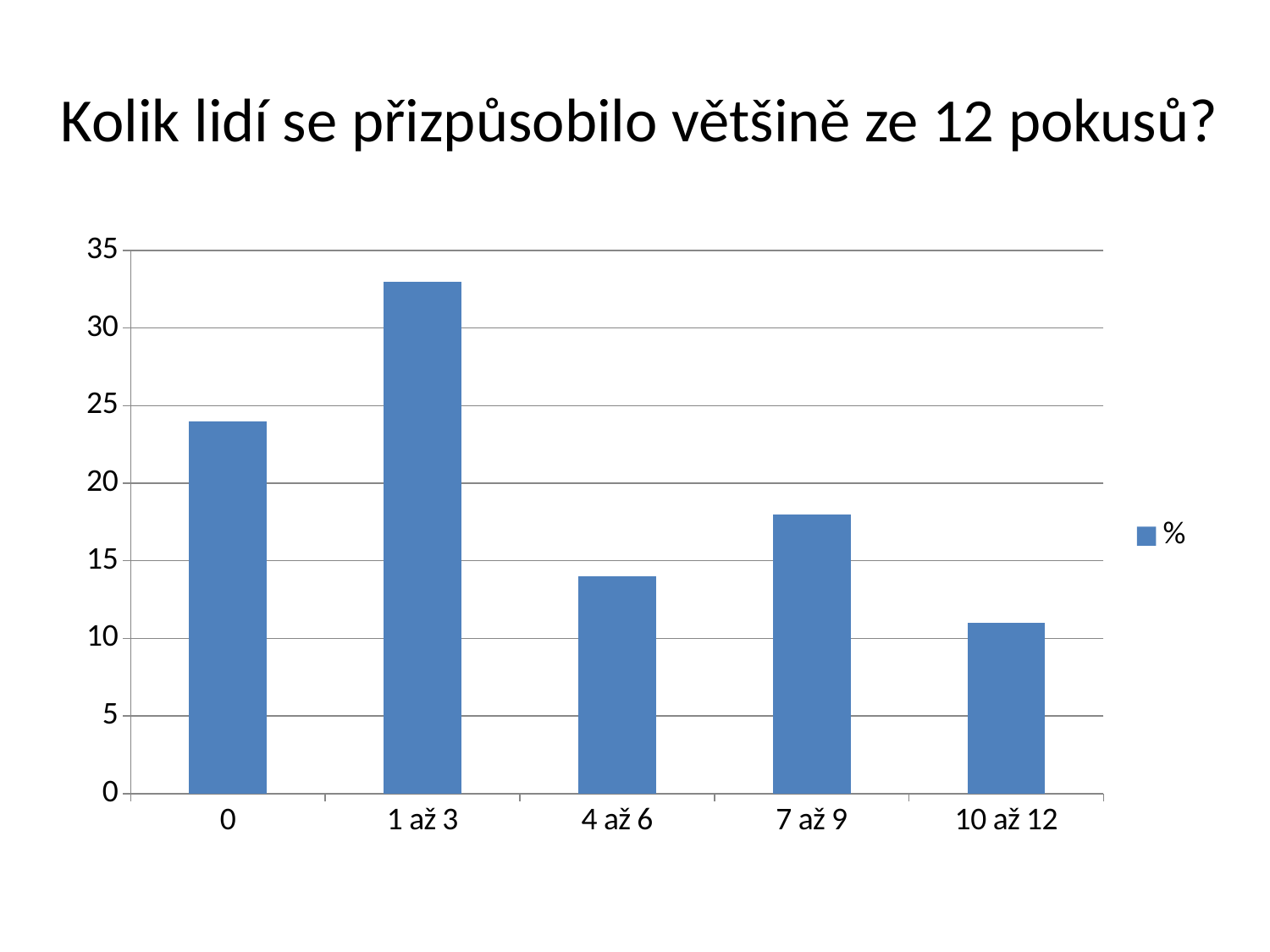
How many series does the legend list? 1 What kind of chart is shown on the slide? bar chart Is the value for 1 až 3 greater or less than 30? greater Which is larger, the value for 4 až 6 or the value for 10 až 12? 4 až 6 Which category has the lowest bar? 10 až 12 Is the value for 0 greater or less than 25? less Which category has the highest bar? 1 až 3 Is the value for 7 až 9 greater or less than 15? greater Which is larger, the value for 0 or the value for 7 až 9? 0 How many categories are shown on the x axis? 5